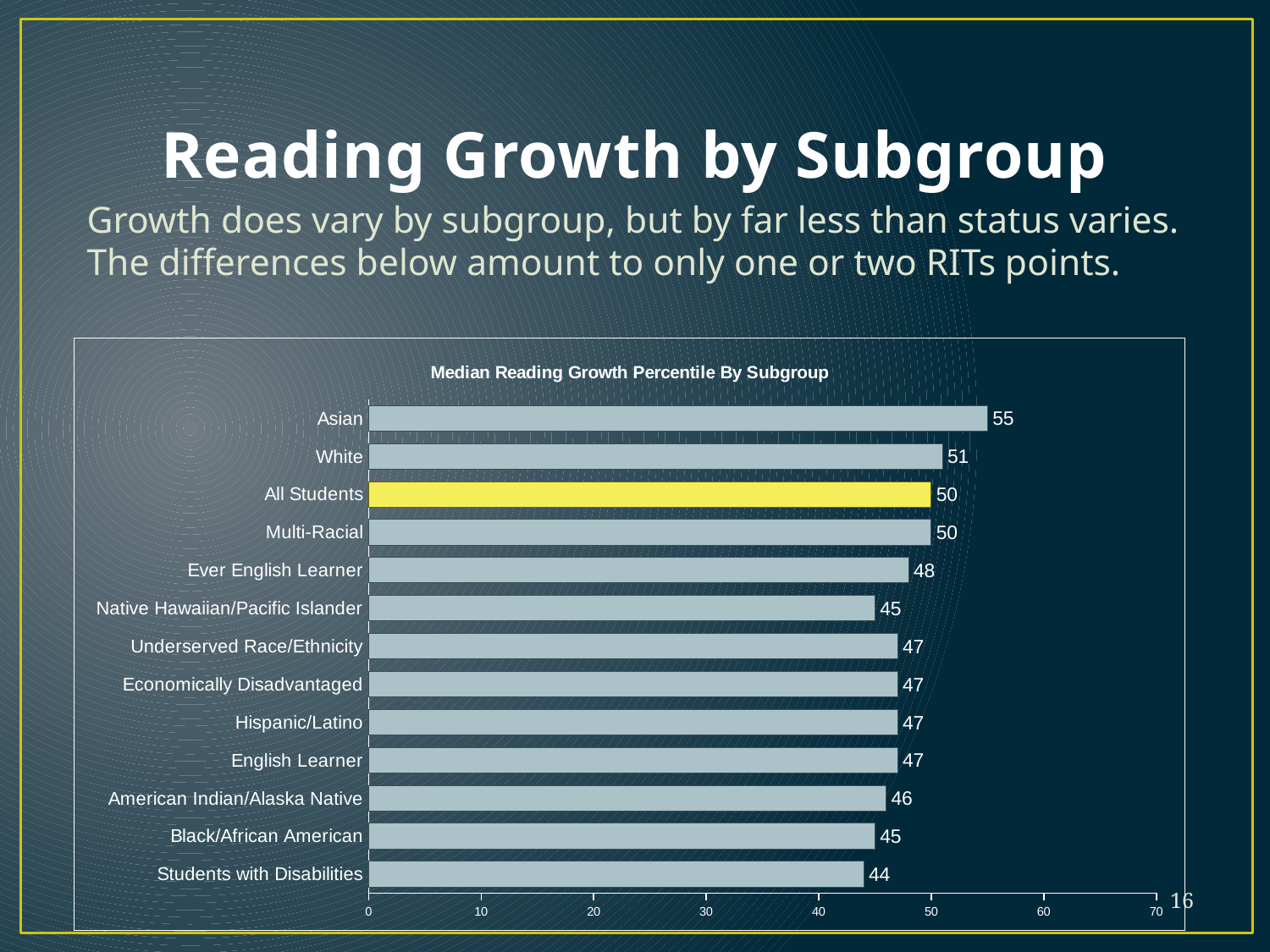
What is the title of the chart? Median Reading Growth Percentile By Subgroup What is the value shown for Ever English Learner? 48 What kind of chart is shown on the slide? Bar chart What is the value shown for Students with Disabilities? 44 Which subgroup has the lowest median reading growth percentile? Students with Disabilities Which subgroup has the highest median reading growth percentile? Asian What is the difference between the values for Asian and Students with Disabilities? 11 What is the difference between the values for White and All Students? 1 What is the median reading growth percentile for Asian students? 55 Which bar is highlighted in yellow? All Students Which is larger, the value for Multi-Racial or the value for Black/African American? Multi-Racial How many subgroups (bars) are shown in the chart? 13